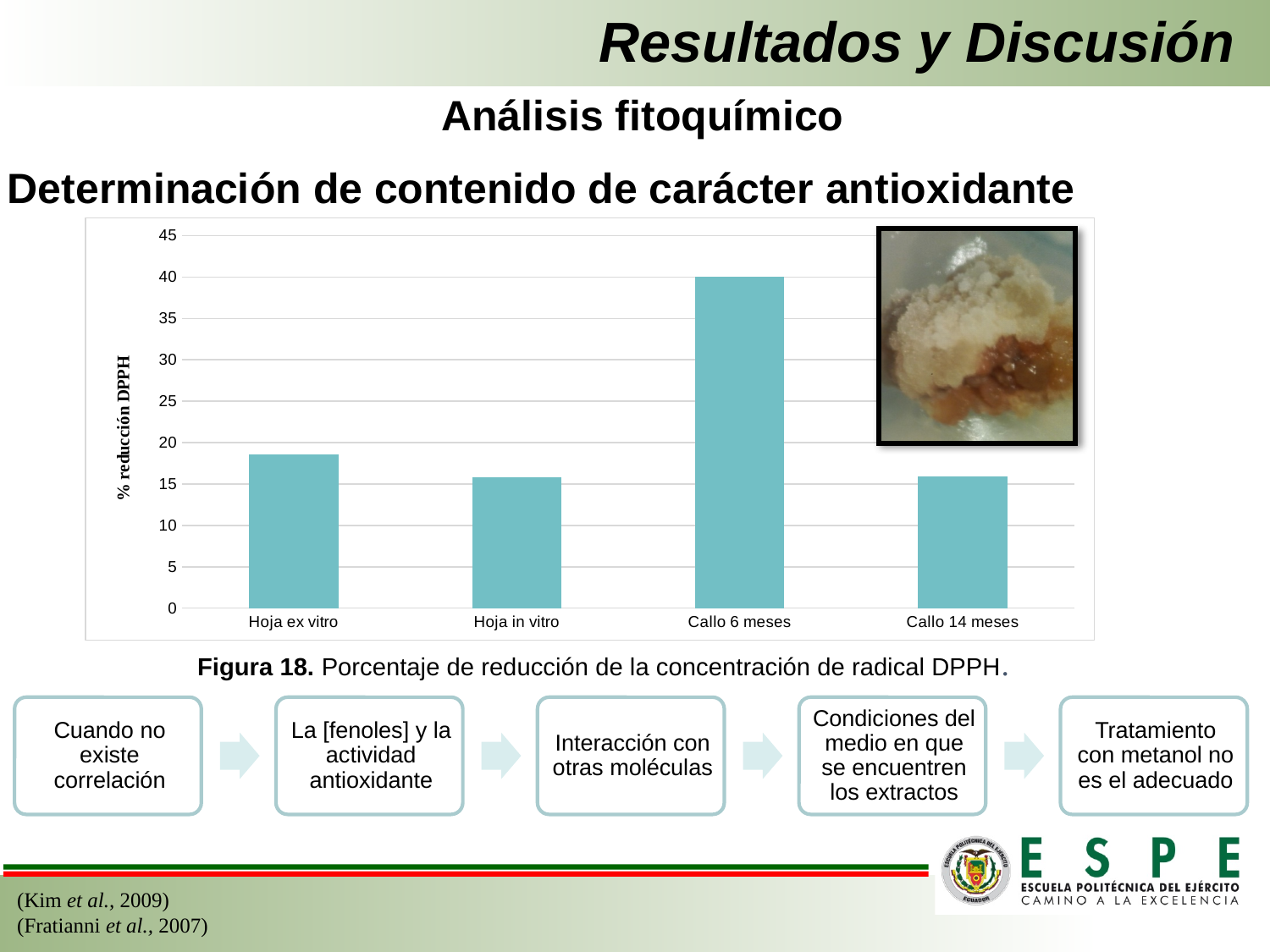
Which is larger, the value for Callo 6 meses or the value for Callo 14 meses? Callo 6 meses Is the value for Hoja ex vitro greater or less than 20? less Is the value for Hoja ex vitro greater or less than 15? greater Is the value for Hoja in vitro greater or less than 20? less Which category has the highest % reducción DPPH? Callo 6 meses Which is larger, the value for Hoja ex vitro or the value for Hoja in vitro? Hoja ex vitro What is the label of the y axis of the chart? % reducción DPPH How many categories are shown on the x axis of the chart? 4 What kind of chart is shown on the slide? bar chart